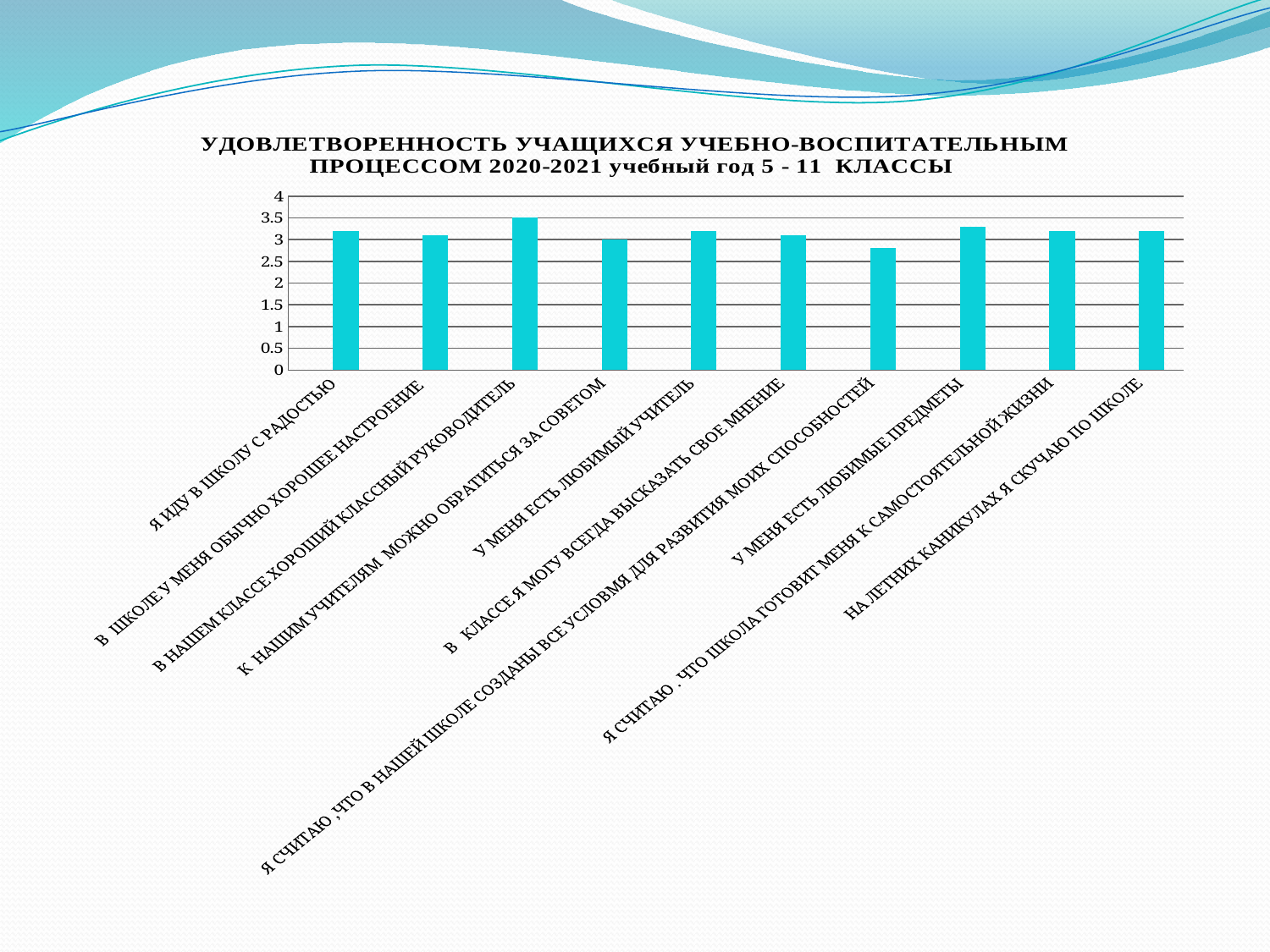
What is the value for "В НАШЕМ КЛАССЕ ХОРОШИЙ КЛАССНЫЙ РУКОВОДИТЕЛЬ"? 3.5 What is the maximum value shown on the vertical axis of the chart? 4 Is the value for "Я СЧИТАЮ, ЧТО В НАШЕЙ ШКОЛЕ СОЗДАНЫ ВСЕ УСЛОВИЯ ДЛЯ РАЗВИТИЯ МОИХ СПОСОБНОСТЕЙ" greater or less than 3? less Is the value for "Я ИДУ В ШКОЛУ С РАДОСТЬЮ" greater or less than 3? greater Is the value for "У МЕНЯ ЕСТЬ ЛЮБИМЫЕ ПРЕДМЕТЫ" greater or less than 3? greater What kind of chart is shown on the slide? bar chart What is the value for "К НАШИМ УЧИТЕЛЯМ МОЖНО ОБРАТИТЬСЯ ЗА СОВЕТОМ"? 3 Which is larger: the value for "У МЕНЯ ЕСТЬ ЛЮБИМЫЕ ПРЕДМЕТЫ" or for "К НАШИМ УЧИТЕЛЯМ МОЖНО ОБРАТИТЬСЯ ЗА СОВЕТОМ"? У МЕНЯ ЕСТЬ ЛЮБИМЫЕ ПРЕДМЕТЫ Which is larger: the value for "В НАШЕМ КЛАССЕ ХОРОШИЙ КЛАССНЫЙ РУКОВОДИТЕЛЬ" or for "Я СЧИТАЮ, ЧТО В НАШЕЙ ШКОЛЕ СОЗДАНЫ ВСЕ УСЛОВИЯ ДЛЯ РАЗВИТИЯ МОИХ СПОСОБНОСТЕЙ"? В НАШЕМ КЛАССЕ ХОРОШИЙ КЛАССНЫЙ РУКОВОДИТЕЛЬ How many categories (statements) are plotted on the chart? 10 Which statement has the lowest value on the chart? Я СЧИТАЮ, ЧТО В НАШЕЙ ШКОЛЕ СОЗДАНЫ ВСЕ УСЛОВИЯ ДЛЯ РАЗВИТИЯ МОИХ СПОСОБНОСТЕЙ Which statement has the highest value on the chart? В НАШЕМ КЛАССЕ ХОРОШИЙ КЛАССНЫЙ РУКОВОДИТЕЛЬ